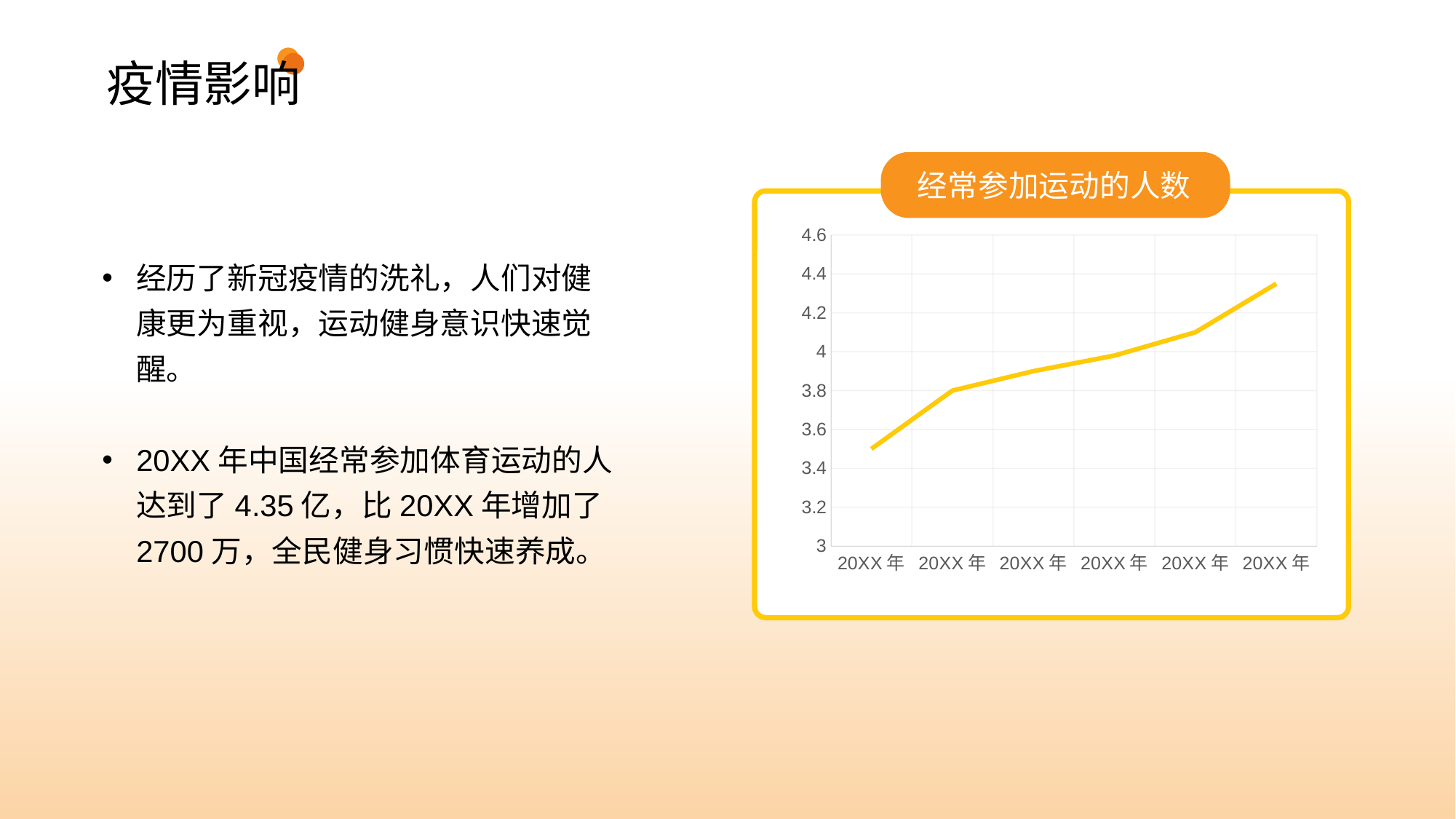
Is the value of the first (leftmost) point greater or less than 3.4? greater What is the title of the chart? 经常参加运动的人数 Which point on the line is the highest? the last (rightmost) point Is the value of the last (rightmost) point greater or less than 4.2? greater Is the value of the second point from the left greater or less than 3.6? greater What kind of chart is shown on the slide? line chart Is the value of the last (rightmost) point larger or smaller than the value of the first (leftmost) point? larger Which point on the line is the lowest? the first (leftmost) point What colour is the plotted line? yellow Do the values rise or fall from left to right along the x axis? rise How many data points are plotted on the line? 6